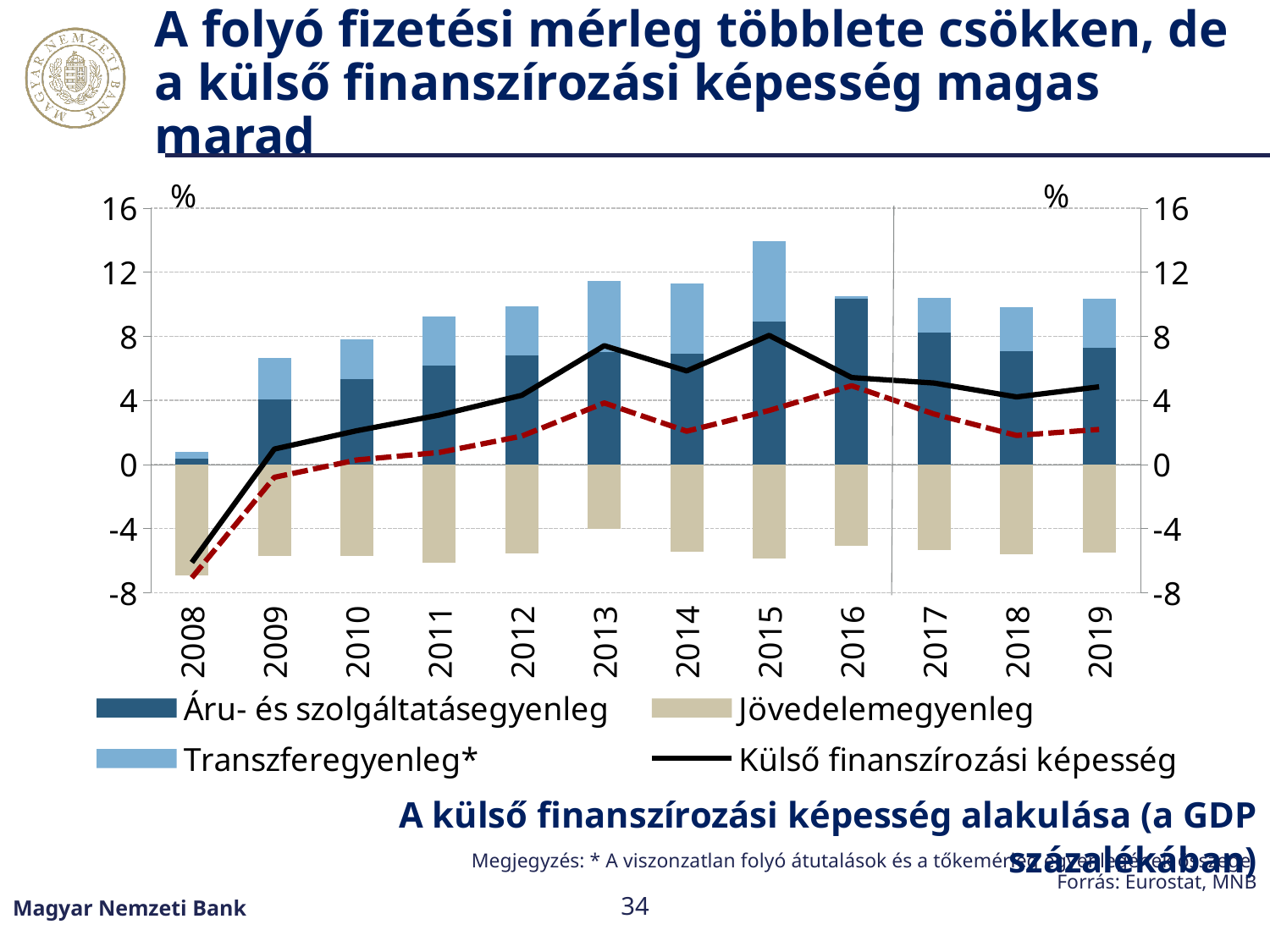
Which year has the larger Áru- és szolgáltatásegyenleg bar, 2009 or 2016? 2016 Is the value of Külső finanszírozási képesség in 2015 greater or less than 4? greater How many years are shown on the x axis of the chart? 12 Does the Külső finanszírozási képesség line rise or fall between 2008 and 2013? rise Is the value of Külső finanszírozási képesség in 2008 greater or less than 0? less In which year is the Külső finanszírozási képesség line at its lowest value? 2008 What kind of chart is shown on the slide? A stacked bar chart combined with a line What unit is shown on the vertical axes of the chart? % How many series does the chart's legend list? 4 Is the Áru- és szolgáltatásegyenleg bar for 2016 greater or less than 8? greater Which year has the larger Külső finanszírozási képesség value, 2015 or 2018? 2015 In which year does the Külső finanszírozási képesség line reach its highest value? 2015